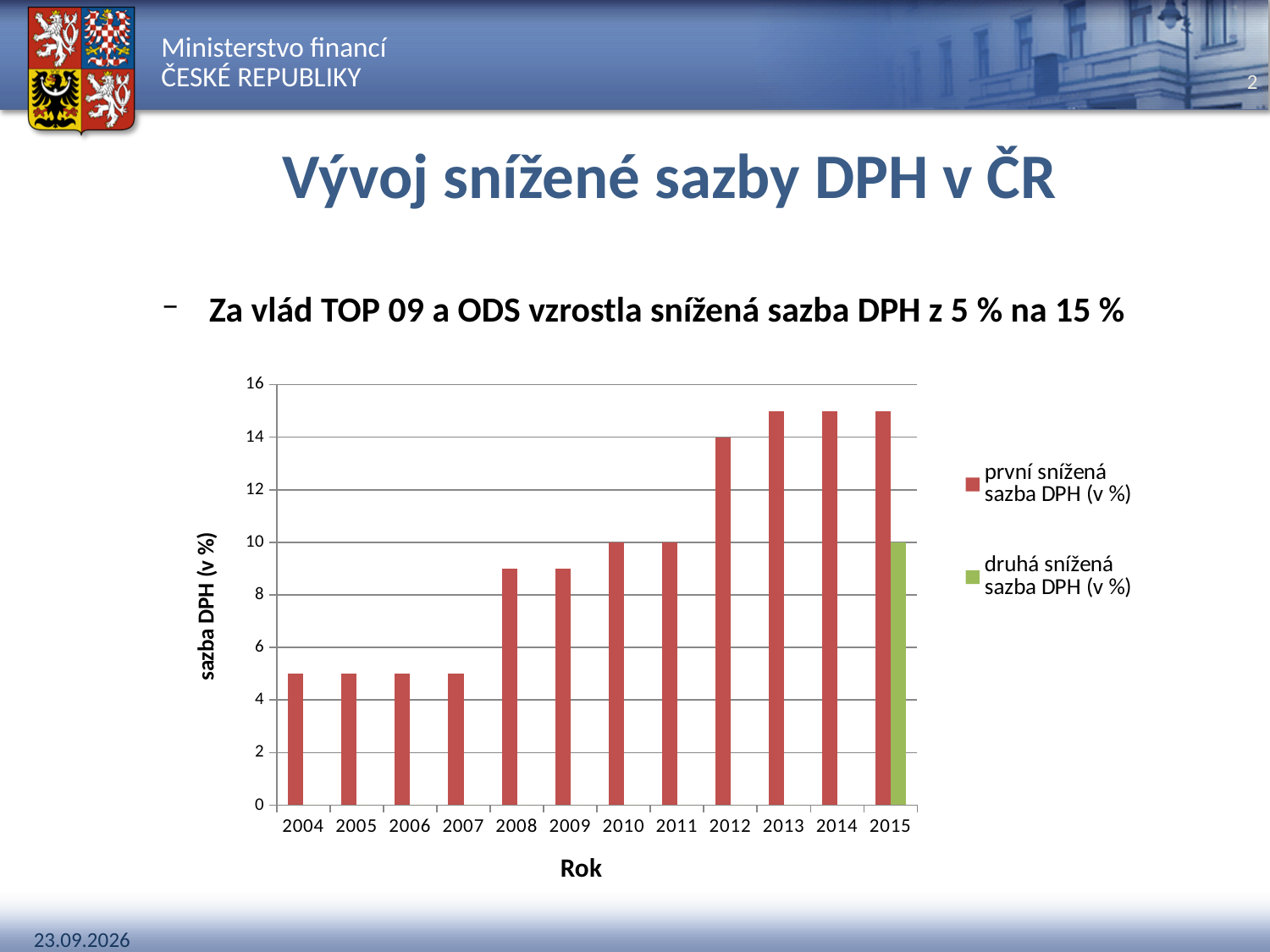
What is the value of 'první snížená sazba DPH (v %)' for 2012? 14 Does the 'první snížená sazba DPH (v %)' series rise or fall from 2004 to 2015? rise How many series does the legend list? 2 What is the value of 'první snížená sazba DPH (v %)' for 2010? 10 How many years are shown on the x axis of the chart? 12 Is the value of 'první snížená sazba DPH (v %)' for 2004 greater or less than 6? less What is the difference between the 'první snížená sazba DPH (v %)' values for 2012 and 2010? 4 Is the value of 'první snížená sazba DPH (v %)' for 2008 greater or less than 8? greater What is the value of 'druhá snížená sazba DPH (v %)' for 2015? 10 Is the value of 'první snížená sazba DPH (v %)' for 2013 greater or less than 14? greater Which year has the larger value of 'první snížená sazba DPH (v %)': 2011 or 2012? 2012 What kind of chart is shown on the slide? bar chart